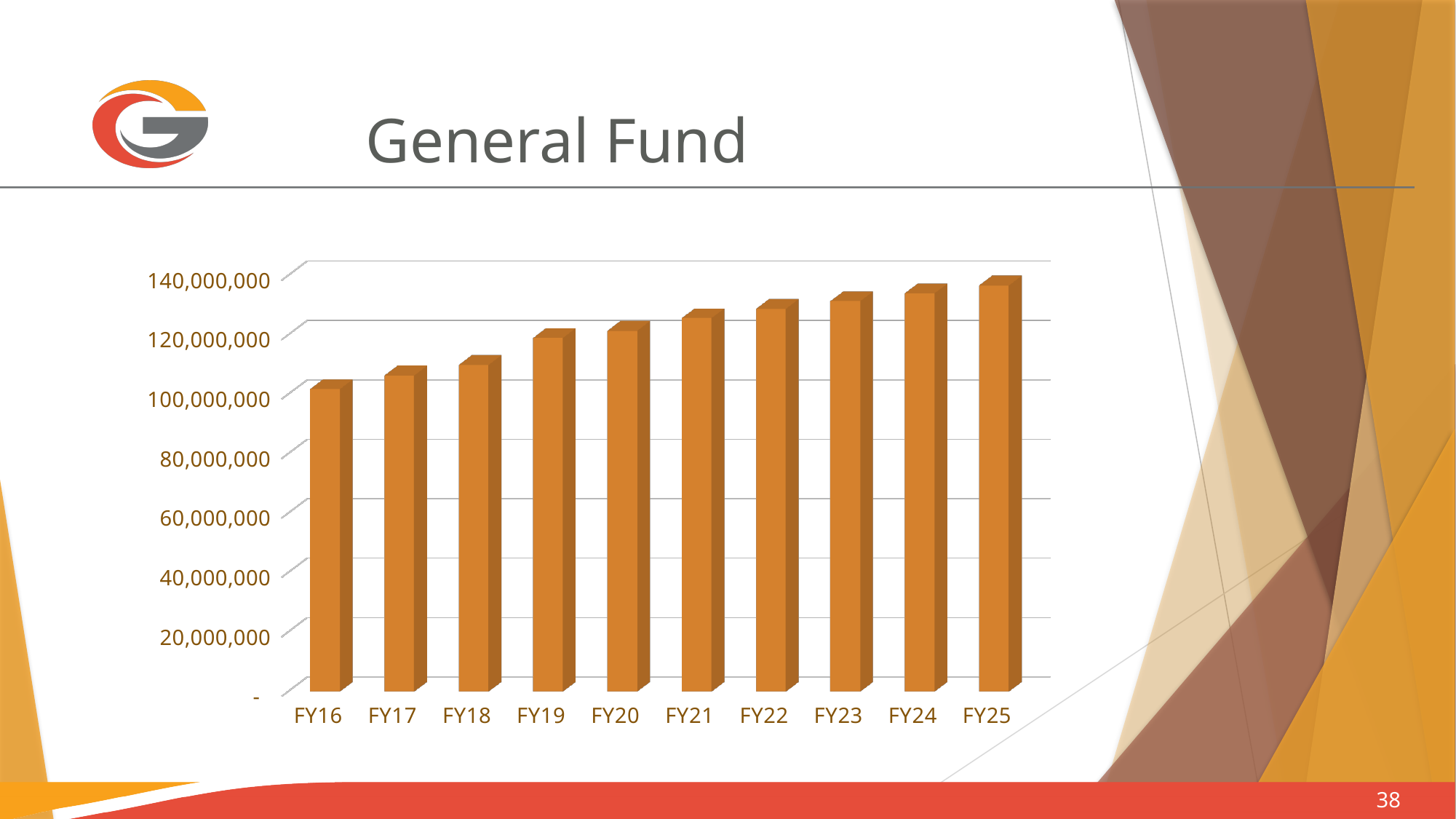
Is the value for FY19 greater or less than 100,000,000? greater What is the title of the slide containing the chart? General Fund Is the value for FY25 greater or less than 120,000,000? greater Which is larger, the value for FY18 or the value for FY23? FY23 Which fiscal year has the highest bar? FY25 What kind of chart is shown on the slide? bar chart Which fiscal year has the lowest bar? FY16 How many fiscal years are plotted on the x axis? 10 Do the values rise or fall from FY16 to FY25? rise Which is larger, the value for FY16 or the value for FY25? FY25 Is the value for FY21 greater or less than 140,000,000? less